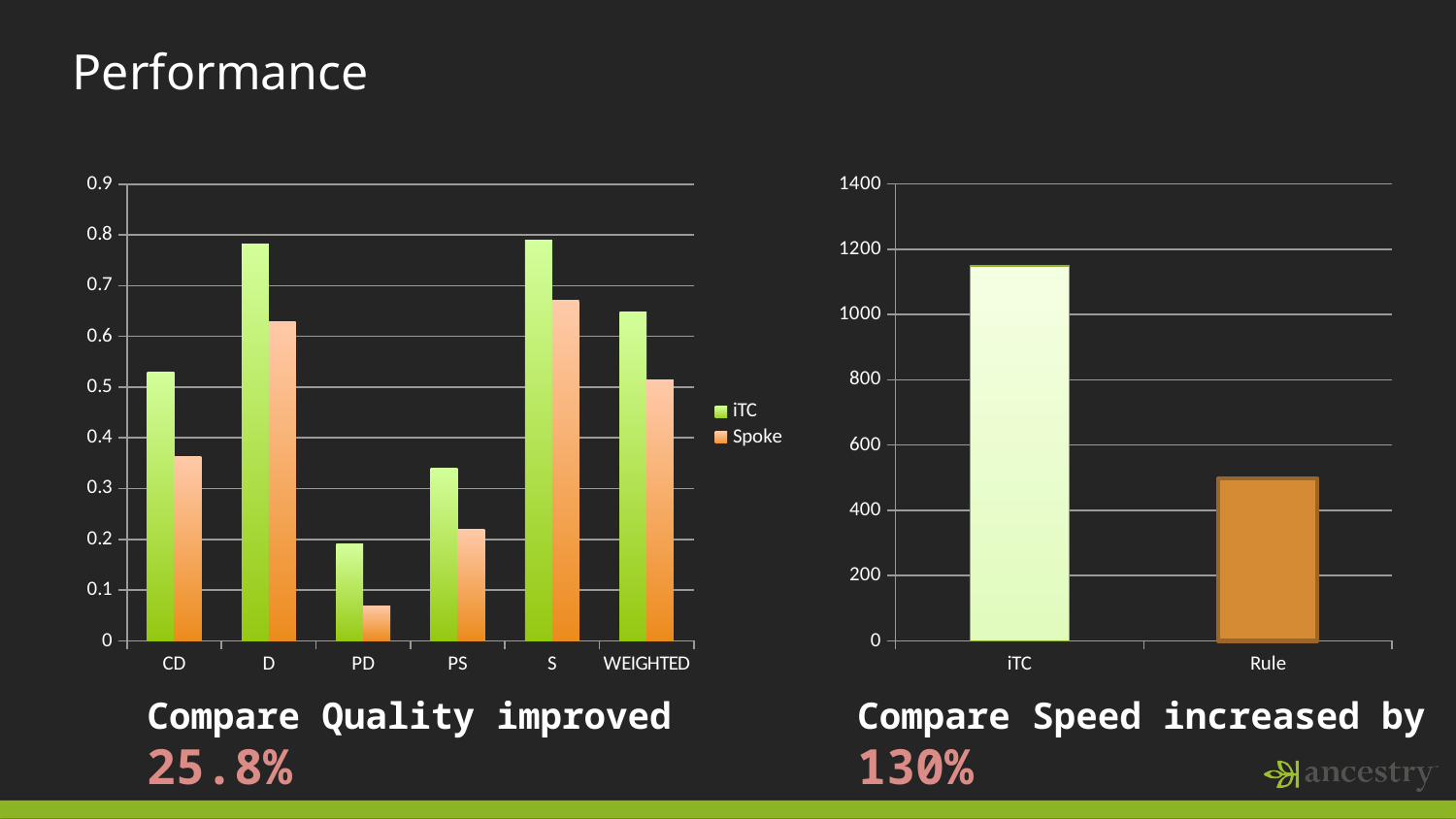
In the left chart, how many categories are shown on the x axis? 6 What kind of chart is the right chart? bar chart In the left chart, for the CD category, which series has the larger value, iTC or Spoke? iTC In the left chart, how many series does the legend list? 2 In the left chart, is the Spoke value for PD greater or less than 0.1? less In the left chart, is the iTC value for CD greater or less than 0.4? greater In the right chart, which category has the highest value? iTC In the right chart, is the value for iTC greater or less than 1000? greater In the left chart, which category has the lowest Spoke value? PD In the left chart, which category has the lowest iTC value? PD